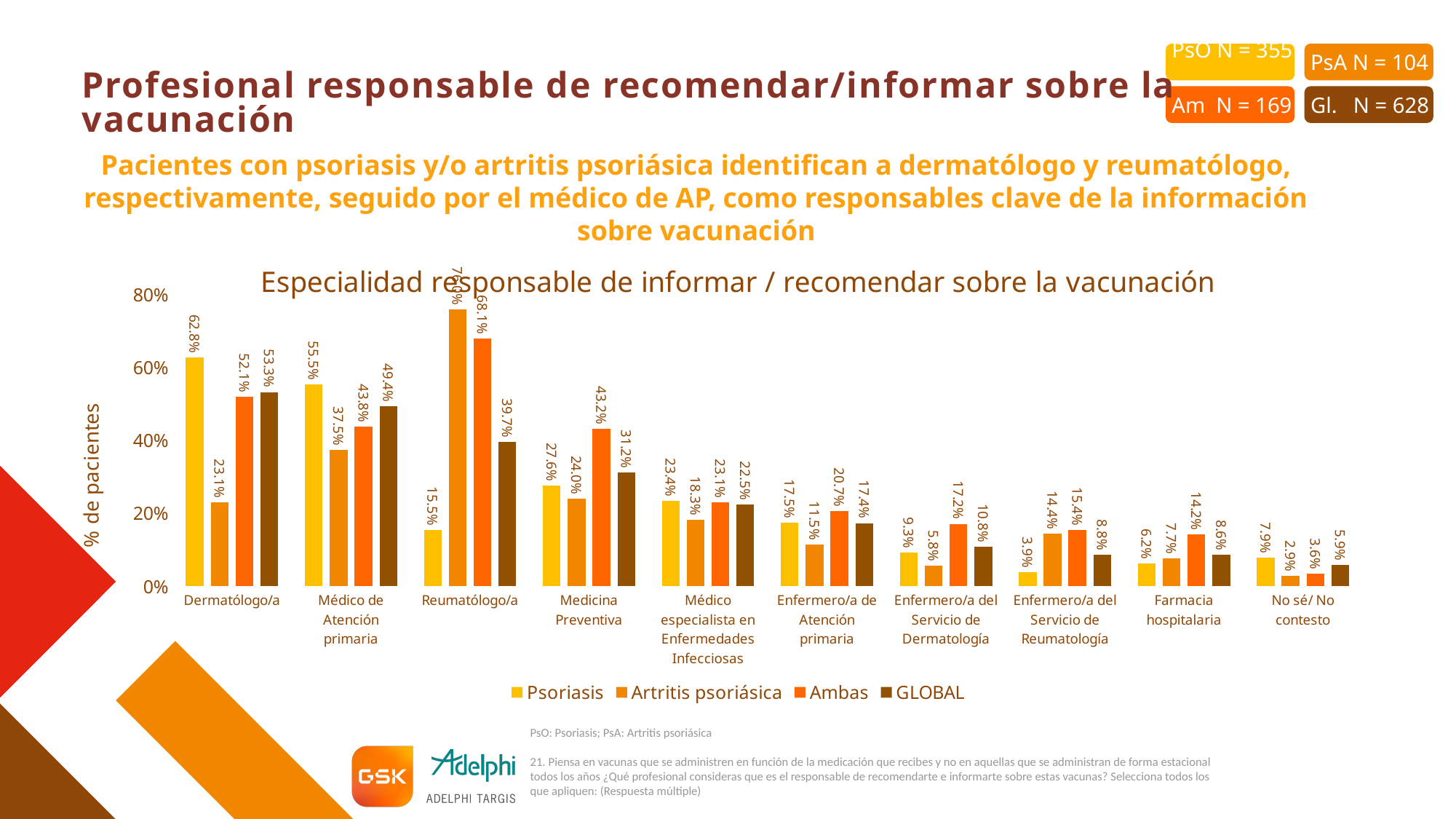
How many categories are shown on the x axis? 10 What kind of chart is shown on the slide? Bar chart What is the Artritis psoriásica value for Medicina Preventiva? 24.0% What is the GLOBAL value for Médico de Atención primaria? 49.4% What is the difference between the Psoriasis and Artritis psoriásica values for Dermatólogo/a? 39.7% What is the Psoriasis value for Dermatólogo/a? 62.8% What is the Ambas value for Reumatólogo/a? 68.1% Which is larger for Farmacia hospitalaria: the Ambas value or the Psoriasis value? Ambas How many series does the legend list? 4 Which category has the highest GLOBAL value? Dermatólogo/a Is the Artritis psoriásica value for Reumatólogo/a greater or less than 60%? greater Which category has the lowest Psoriasis value? Enfermero/a del Servicio de Reumatología